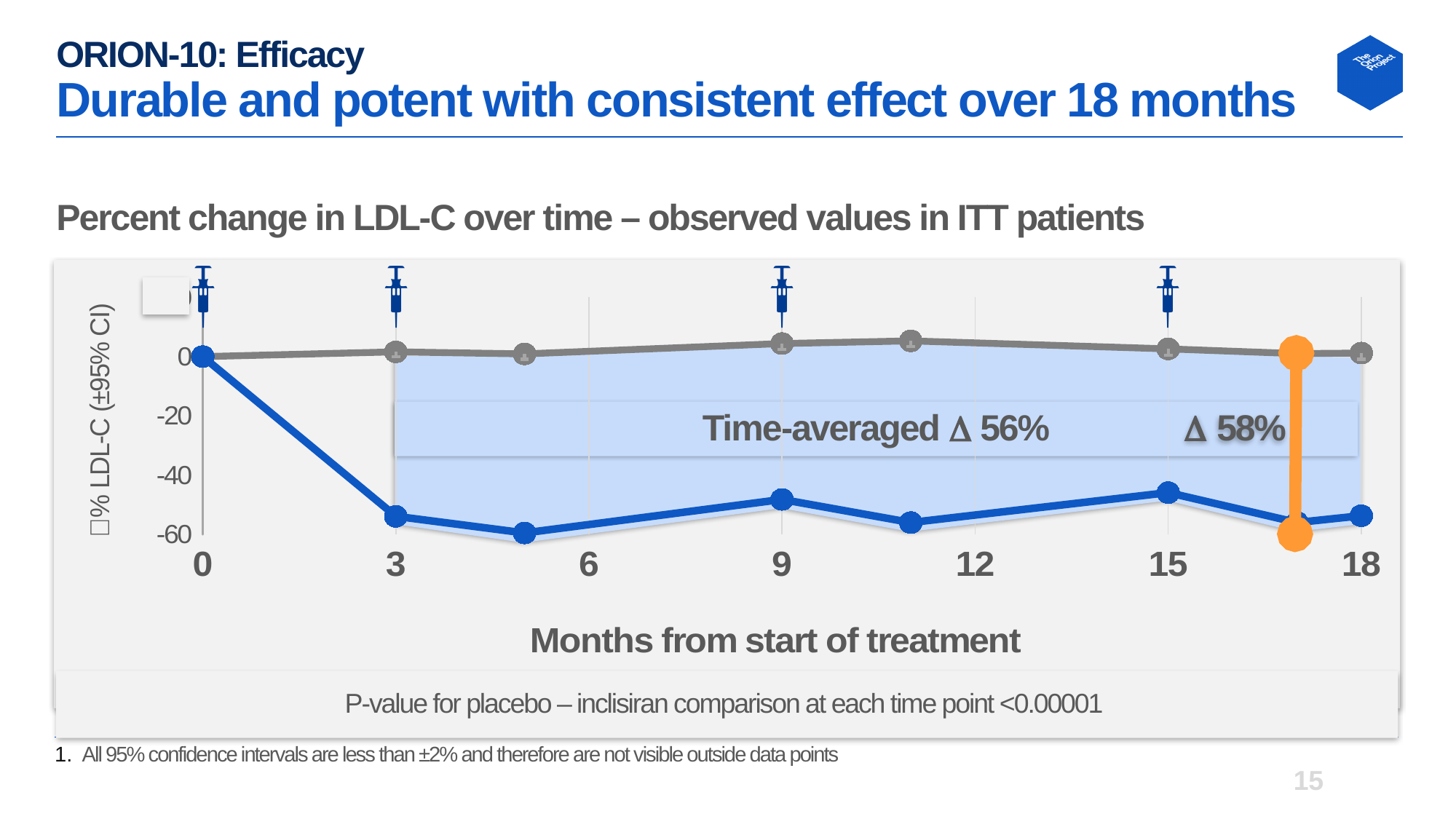
How many tick labels are shown on the x axis? 7 What p-value is stated for the placebo – inclisiran comparison at each time point? <0.00001 Is the value of the grey line at month 18 greater or less than -20? greater What kind of chart is shown on the slide? line chart What is the time-averaged change (Δ) printed on the chart? 56% What is the title of the x axis? Months from start of treatment Does the blue line rise or fall between month 0 and month 3? fall What is the change (Δ) printed next to the orange marker near month 18? 58% What is the lowest value labelled on the y axis? -60 At month 3, which line is higher, the grey line or the blue line? the grey line Is the value of the blue line at month 9 greater or less than -40? less Is the value of the blue line at month 3 greater or less than -40? less